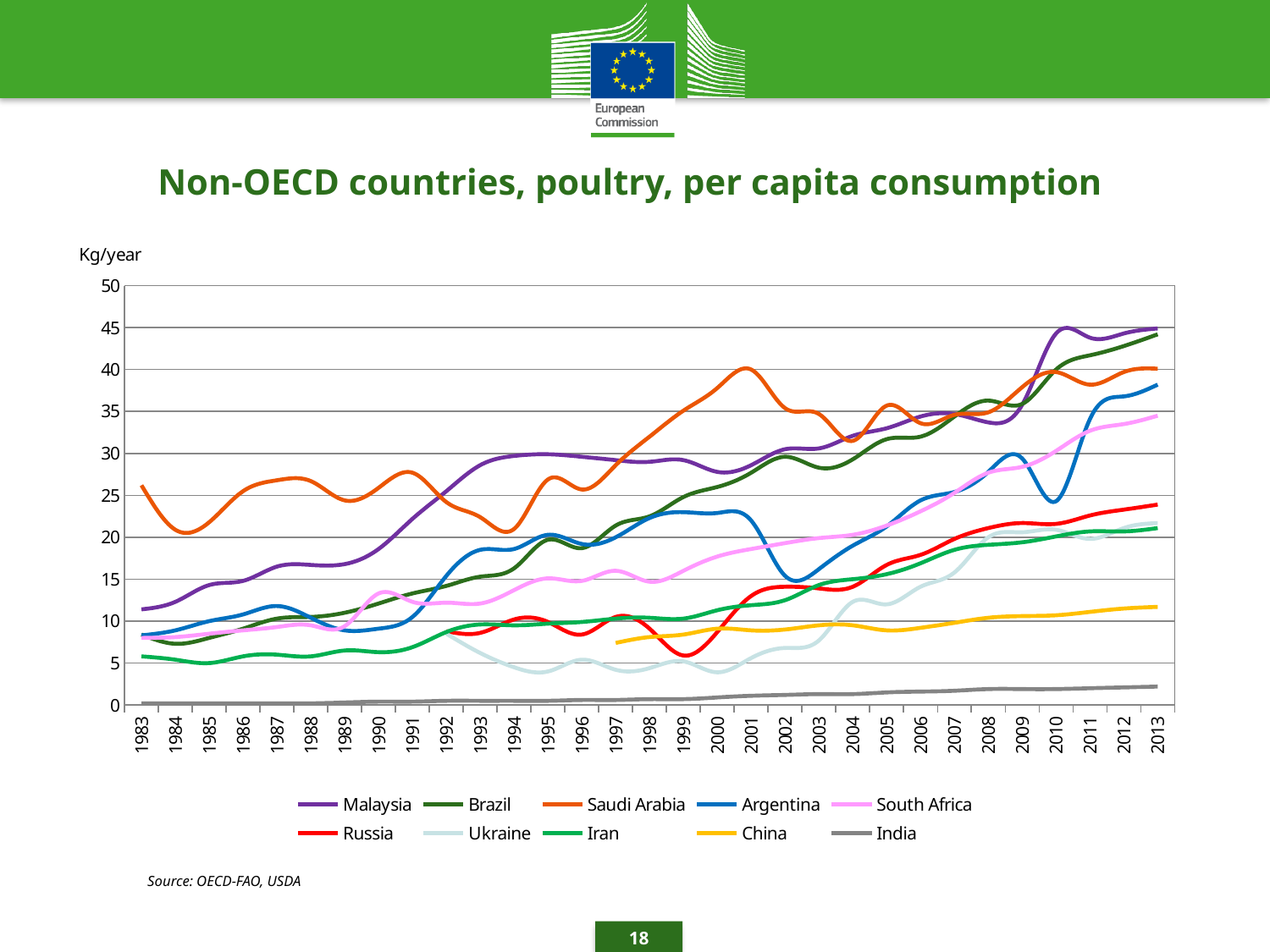
Is the value for Argentina in 2002 greater or less than 20? less Is the value for Saudi Arabia in 2001 greater or less than 35? greater What kind of chart is shown on the slide? Line chart In 1983, which is larger: the value for Saudi Arabia or the value for Malaysia? Saudi Arabia Which country has the lowest poultry consumption per capita in 2013? India What unit is shown on the y axis of the chart? Kg/year In 2013, which is larger: the value for Russia or the value for China? Russia How many countries does the legend list? 10 Is the value for India in 2013 greater or less than 5? less Does the value for India rise or fall from 1983 to 2013? Rise How many years are shown along the x axis? 31